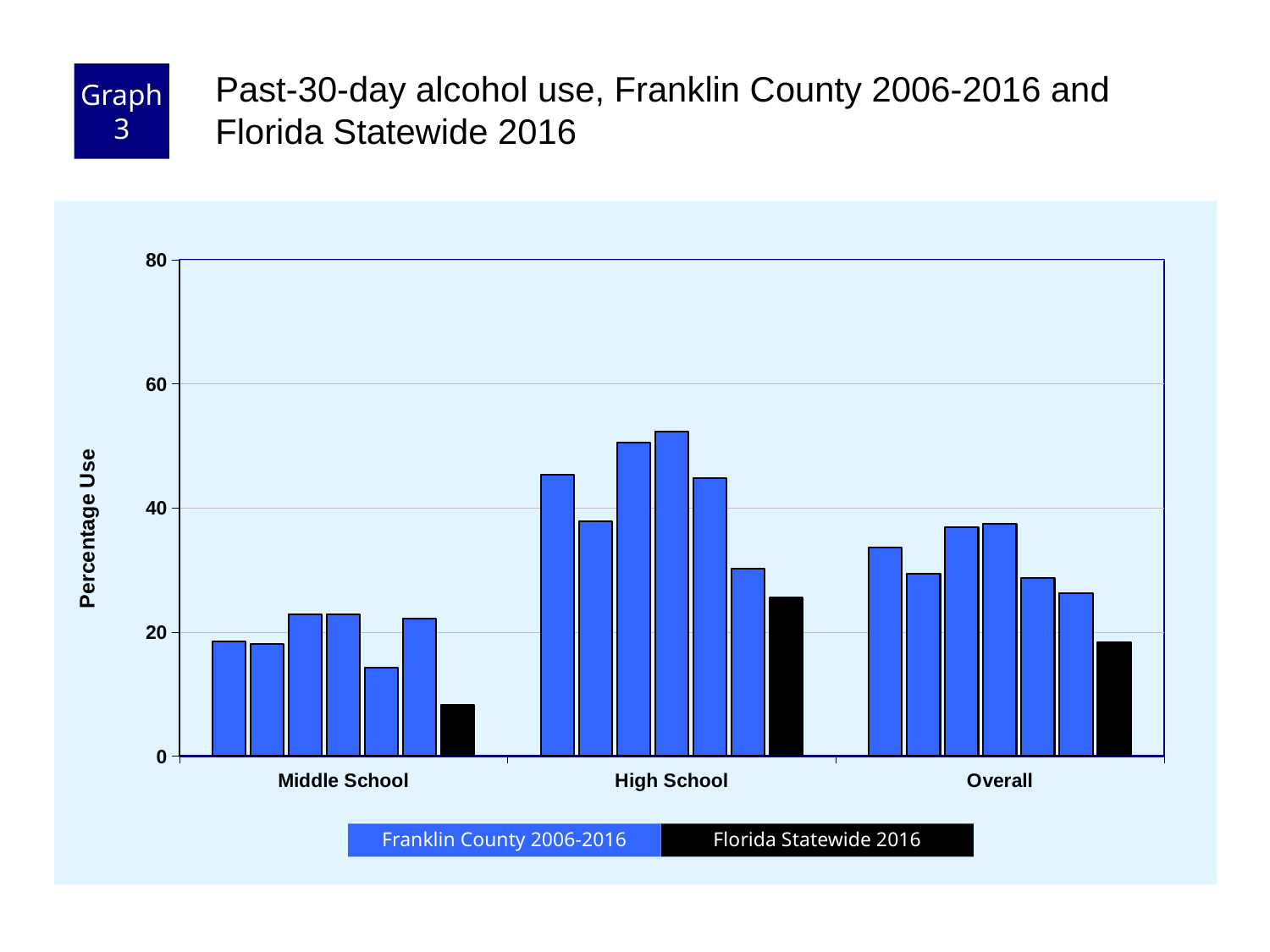
Is the Florida Statewide 2016 value for Middle School greater or less than 20? less Which category group has the lowest Florida Statewide 2016 bar? Middle School Are all of the Middle School bars greater or less than 40? less What is the label on the y axis? Percentage Use Which is larger, the Florida Statewide 2016 value for High School or for Middle School? High School Which category group contains the tallest bar? High School Is the tallest Franklin County 2006-2016 bar for High School greater or less than 40? greater What kind of chart is shown on the slide? bar chart How many series does the legend list? 2 How many category groups are shown along the x axis? 3 What colour are the Florida Statewide 2016 bars? black